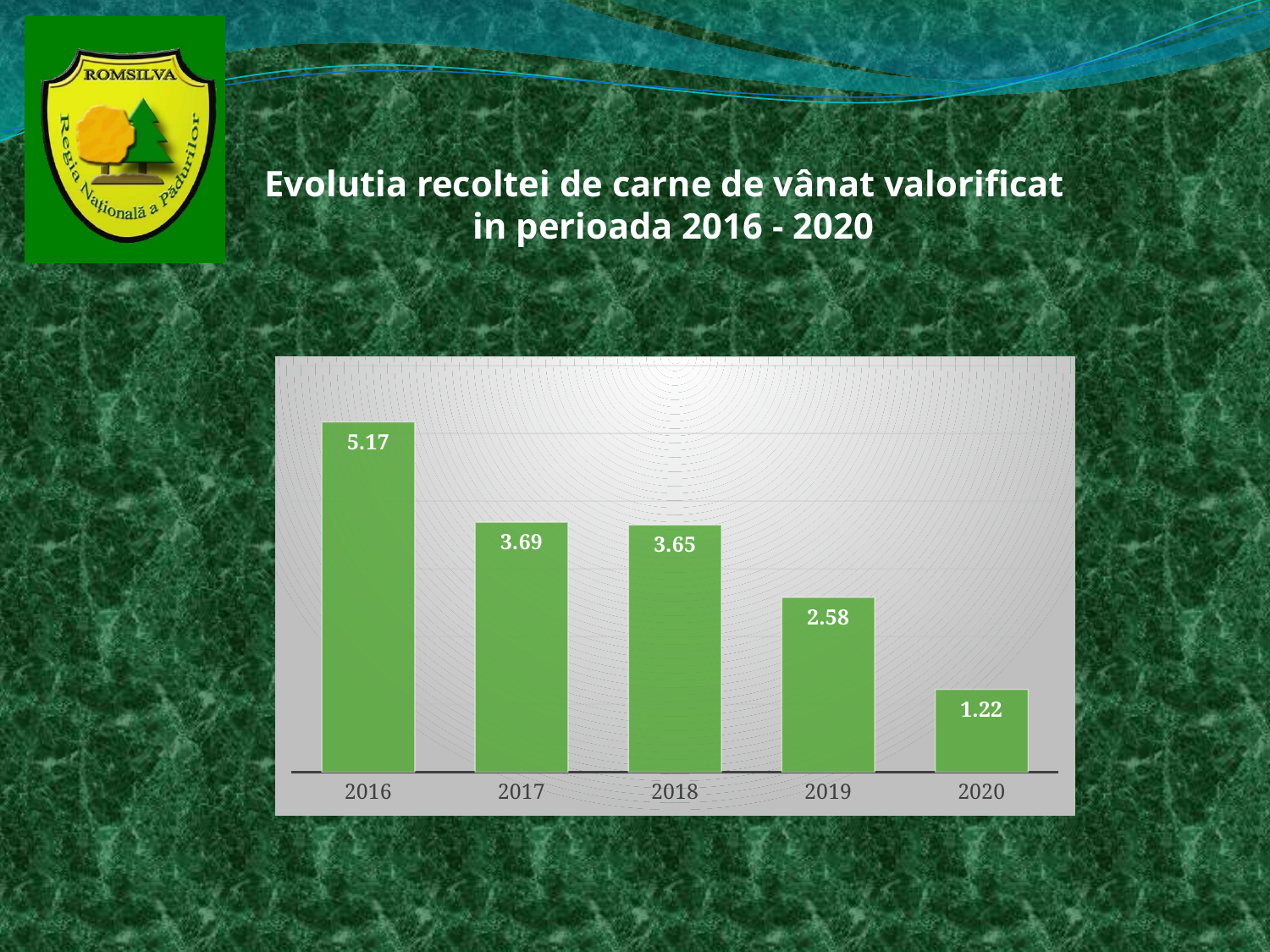
How many years are shown on the x axis? 5 What is the difference between the values for 2017 and 2018? 0.04 What is the title of the slide above the chart? Evolutia recoltei de carne de vânat valorificat in perioada 2016 - 2020 Which is larger, the value for 2018 or the value for 2019? 2018 What is the value for 2016? 5.17 Which year has the lowest value? 2020 Which year has the highest value? 2016 What is the value for 2019? 2.58 What is the value for 2020? 1.22 Do the values rise or fall from 2016 to 2020? fall What kind of chart is shown on the slide? bar chart What is the difference between the values for 2016 and 2020? 3.95